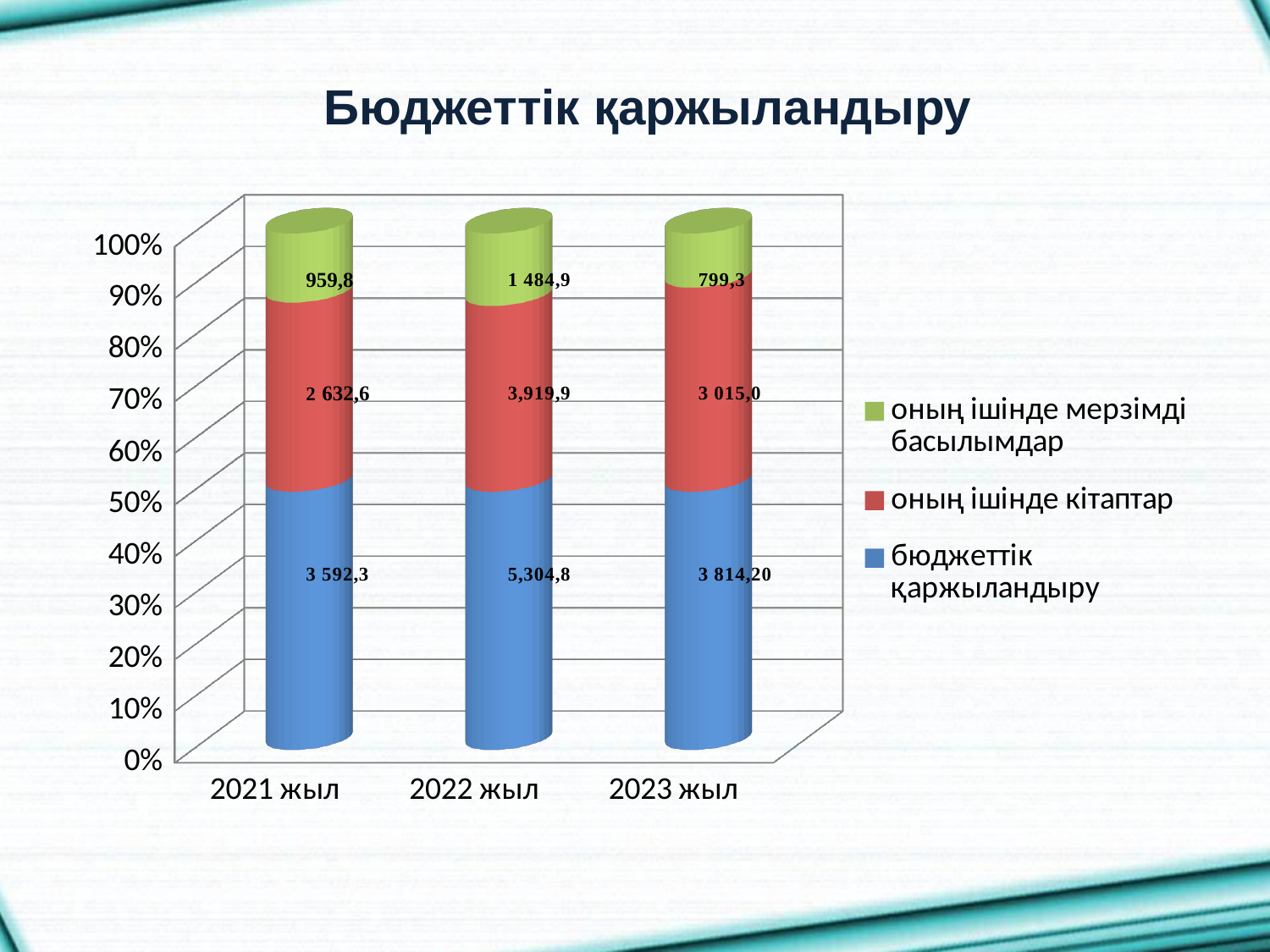
How many years are shown on the x axis? 3 What is the value of оның ішінде кітаптар for 2021 жыл? 2 632,6 What is the title of the chart? Бюджеттік қаржыландыру What is the value of бюджеттік қаржыландыру for 2022 жыл? 5,304,8 Which year has the lowest value for оның ішінде мерзімді басылымдар? 2023 жыл Which year has the highest value for бюджеттік қаржыландыру? 2022 жыл How many series does the legend list? 3 Which is larger: оның ішінде кітаптар for 2023 жыл or for 2021 жыл? 2023 жыл What is the value of бюджеттік қаржыландыру for 2023 жыл? 3 814,20 What kind of chart is shown on the slide? Stacked bar chart What is the difference between the оның ішінде мерзімді басылымдар values for 2022 жыл and 2021 жыл? 525,1 What is the value of оның ішінде мерзімді басылымдар for 2023 жыл? 799,3